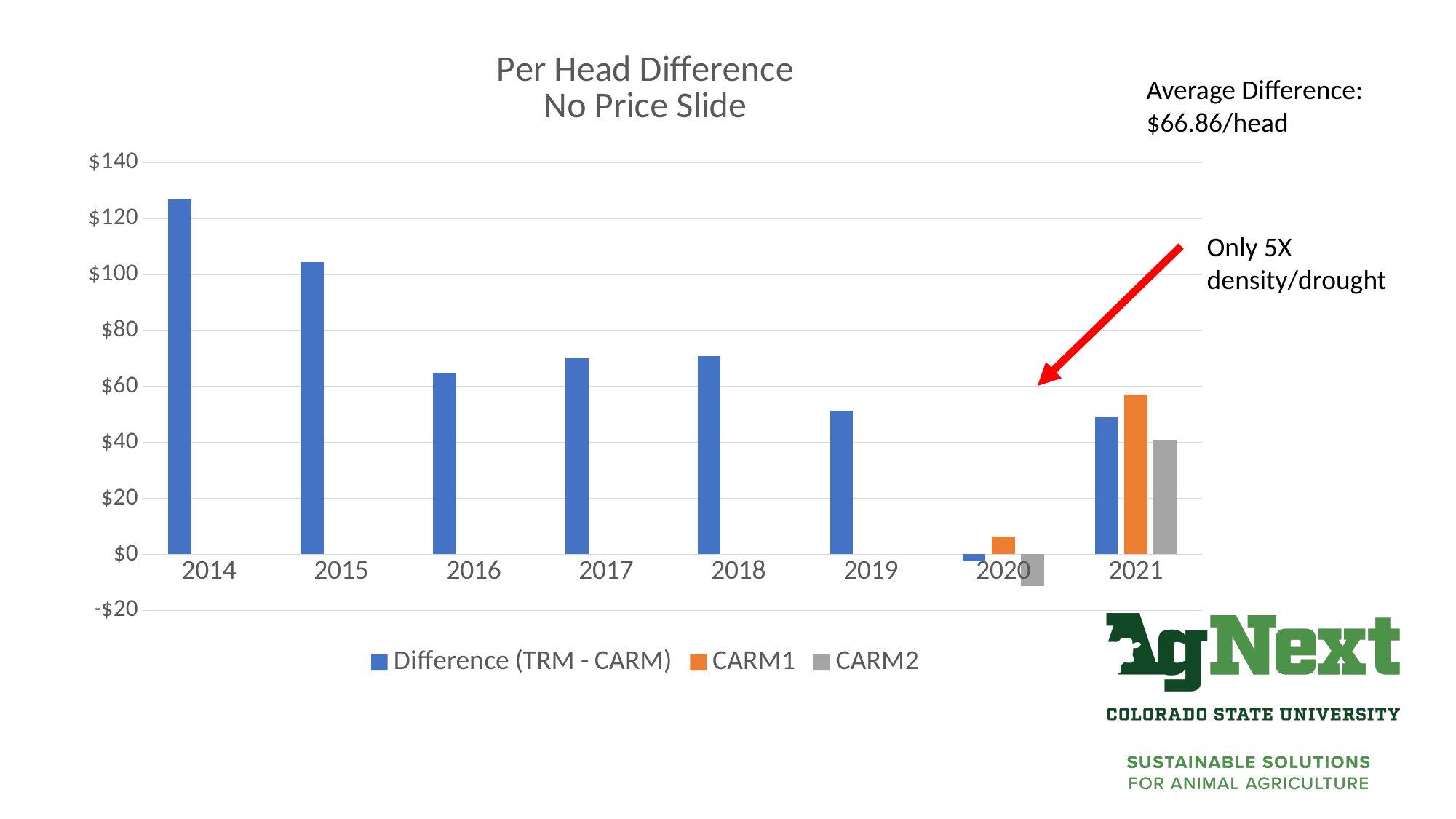
Which year has the lowest value for Difference (TRM - CARM)? 2020 Is the Difference (TRM - CARM) value for 2019 greater or less than $60? less What is the title of the chart? Per Head Difference No Price Slide Is the CARM1 value for 2021 greater or less than $40? greater Which is larger, the Difference (TRM - CARM) value for 2015 or for 2016? 2015 Is the CARM2 value for 2020 greater or less than $0? less How many series does the legend list? 3 Does the Difference (TRM - CARM) series generally rise or fall from 2014 to 2019? fall Which year has the highest value for Difference (TRM - CARM)? 2014 How many years are shown on the x axis? 8 What kind of chart is shown on the slide? bar chart